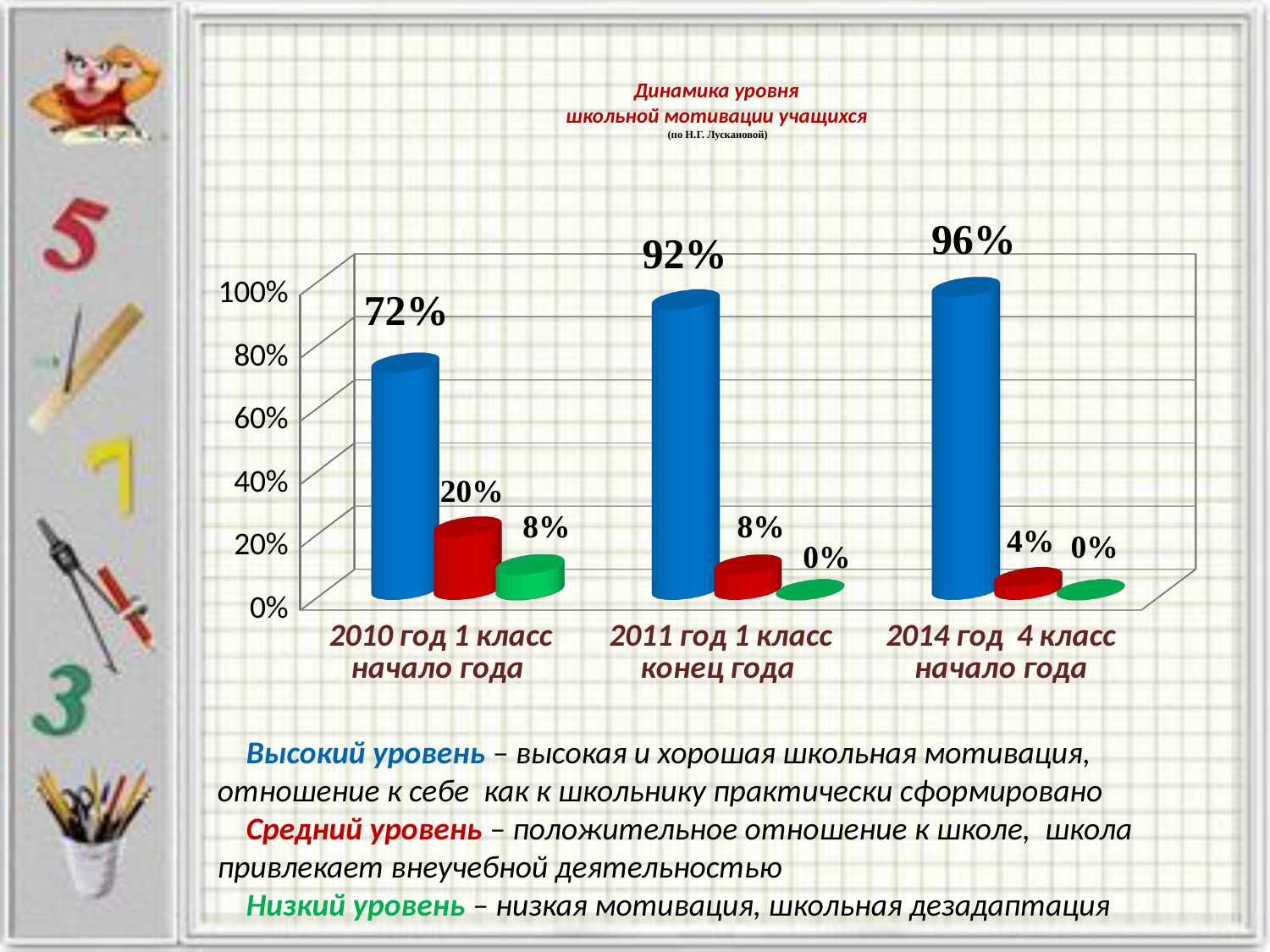
What is the value of the red bar for "2010 год 1 класс начало года"? 20% What kind of chart is shown on the slide? bar chart What is the difference between the blue bar values for "2014 год 4 класс начало года" and "2010 год 1 класс начало года"? 24% What is the value of the green bar for "2014 год 4 класс начало года"? 0% What is the title of the chart? Динамика уровня школьной мотивации учащихся Do the blue bar values rise or fall from left to right across the categories? rise What is the value of the red bar for "2011 год 1 класс конец года"? 8% Which is larger: the red bar for "2010 год 1 класс начало года" or the red bar for "2014 год 4 класс начало года"? 2010 год 1 класс начало года What is the value of the blue bar for "2010 год 1 класс начало года"? 72% Which category has the highest blue bar? 2014 год 4 класс начало года Which category has the lowest blue bar? 2010 год 1 класс начало года How many categories are shown on the x axis? 3